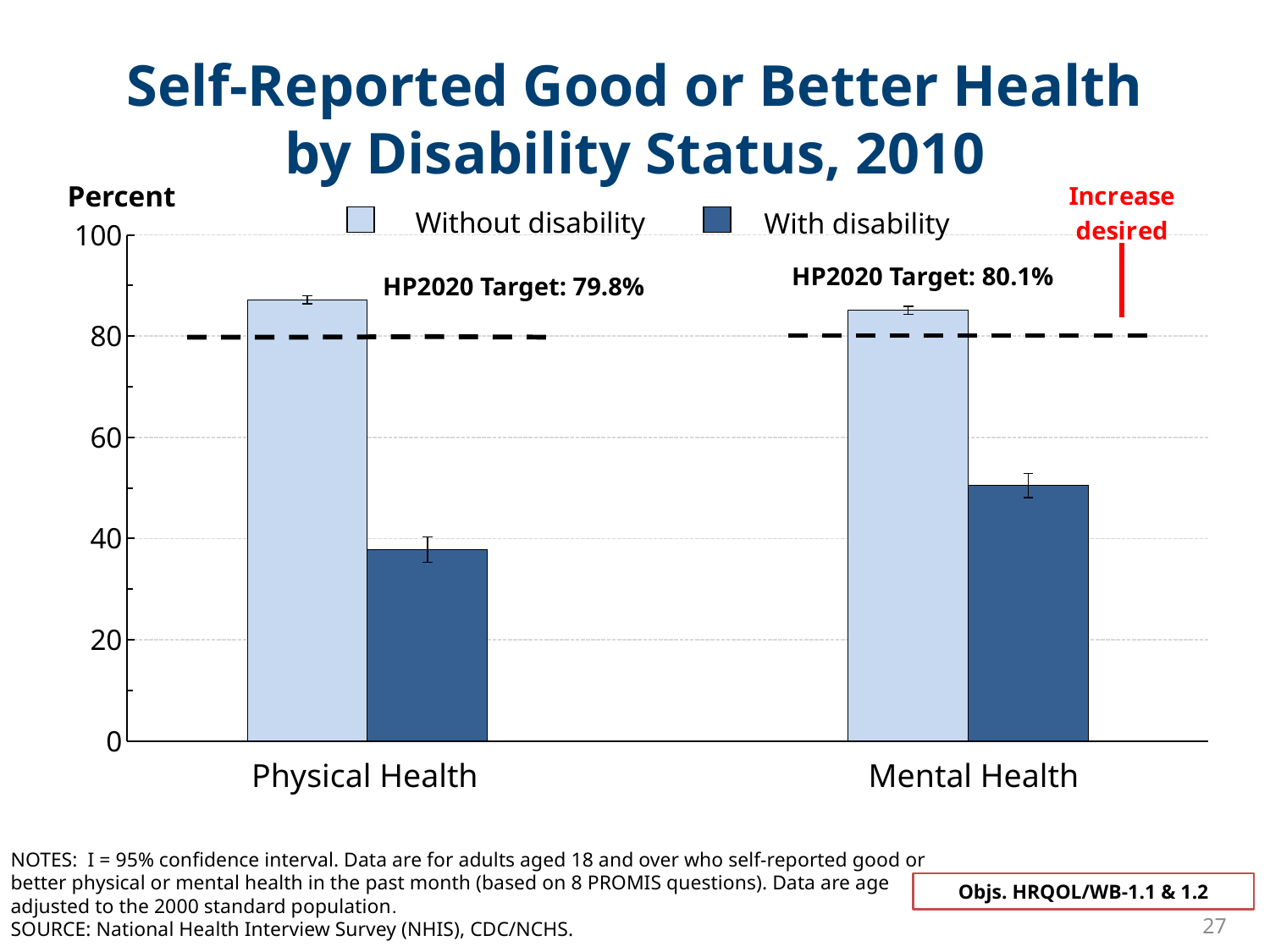
Is the value for Mental Health, With disability greater or less than 40? greater Is the value for Mental Health, With disability greater or less than 60? less For Physical Health, which is larger: Without disability or With disability? Without disability Is the value for Physical Health, With disability greater or less than 40? less For With disability, which is larger: Physical Health or Mental Health? Mental Health Which bar is the lowest in the chart? Physical Health, With disability How many series does the legend list? 2 What is the HP2020 Target shown for Physical Health? 79.8% How many categories are shown on the x axis? 2 What is the HP2020 Target shown for Mental Health? 80.1% What kind of chart is shown on the slide? bar chart